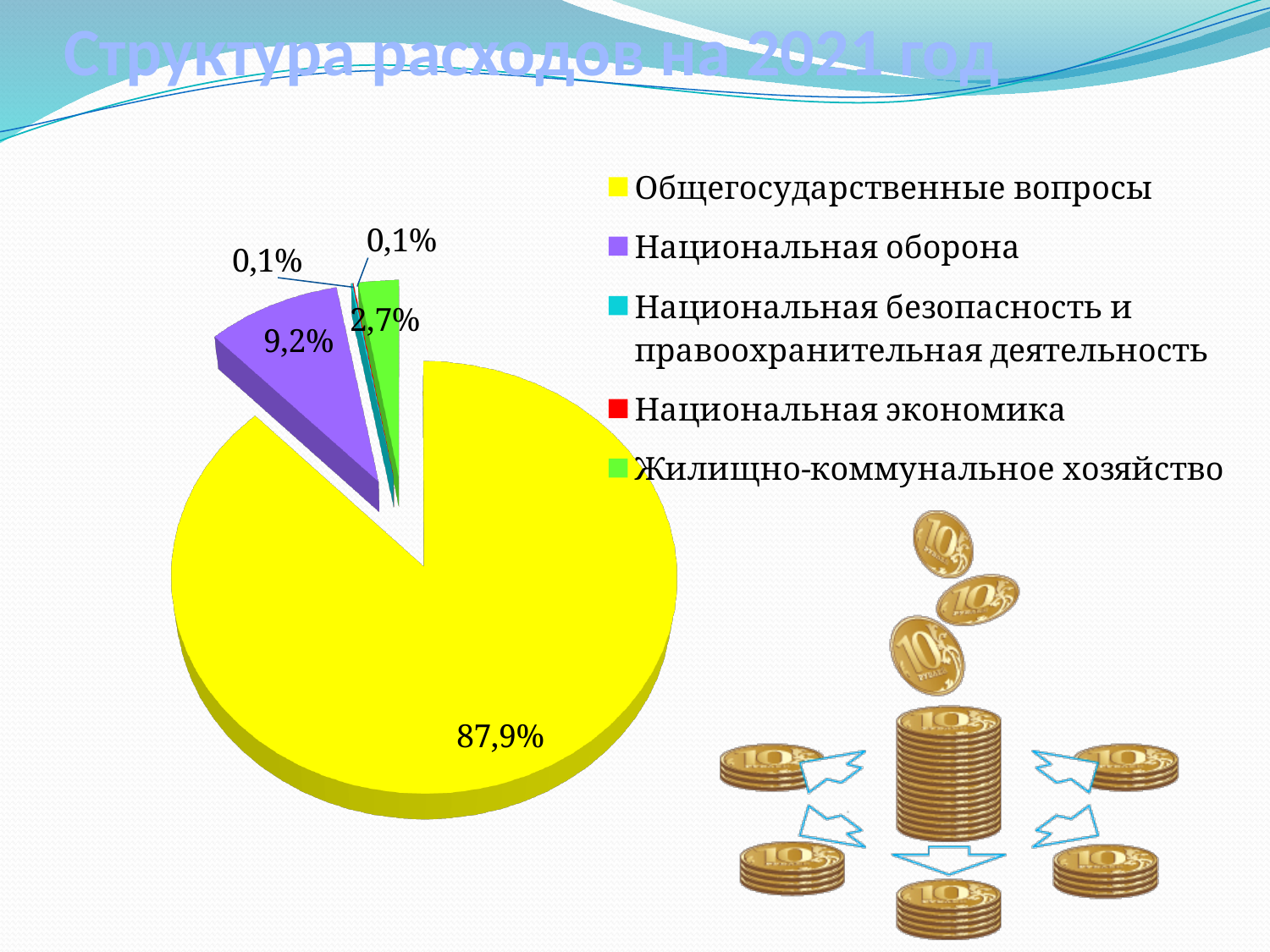
How many categories does the legend list? 5 What share of expenditures is Жилищно-коммунальное хозяйство? 2,7% What is the title of the chart? Структура расходов на 2021 год What kind of chart is shown on the slide? pie chart What share of expenditures is Общегосударственные вопросы? 87,9% What colour is the slice for Национальная оборона? purple Which is larger: the share for Национальная оборона or for Жилищно-коммунальное хозяйство? Национальная оборона What share of expenditures is Национальная экономика? 0,1% What is the difference between the shares for Общегосударственные вопросы and Национальная оборона? 78,7% What share of expenditures is Национальная оборона? 9,2% Which category has the largest share of expenditures? Общегосударственные вопросы What share of expenditures is Национальная безопасность и правоохранительная деятельность? 0,1%